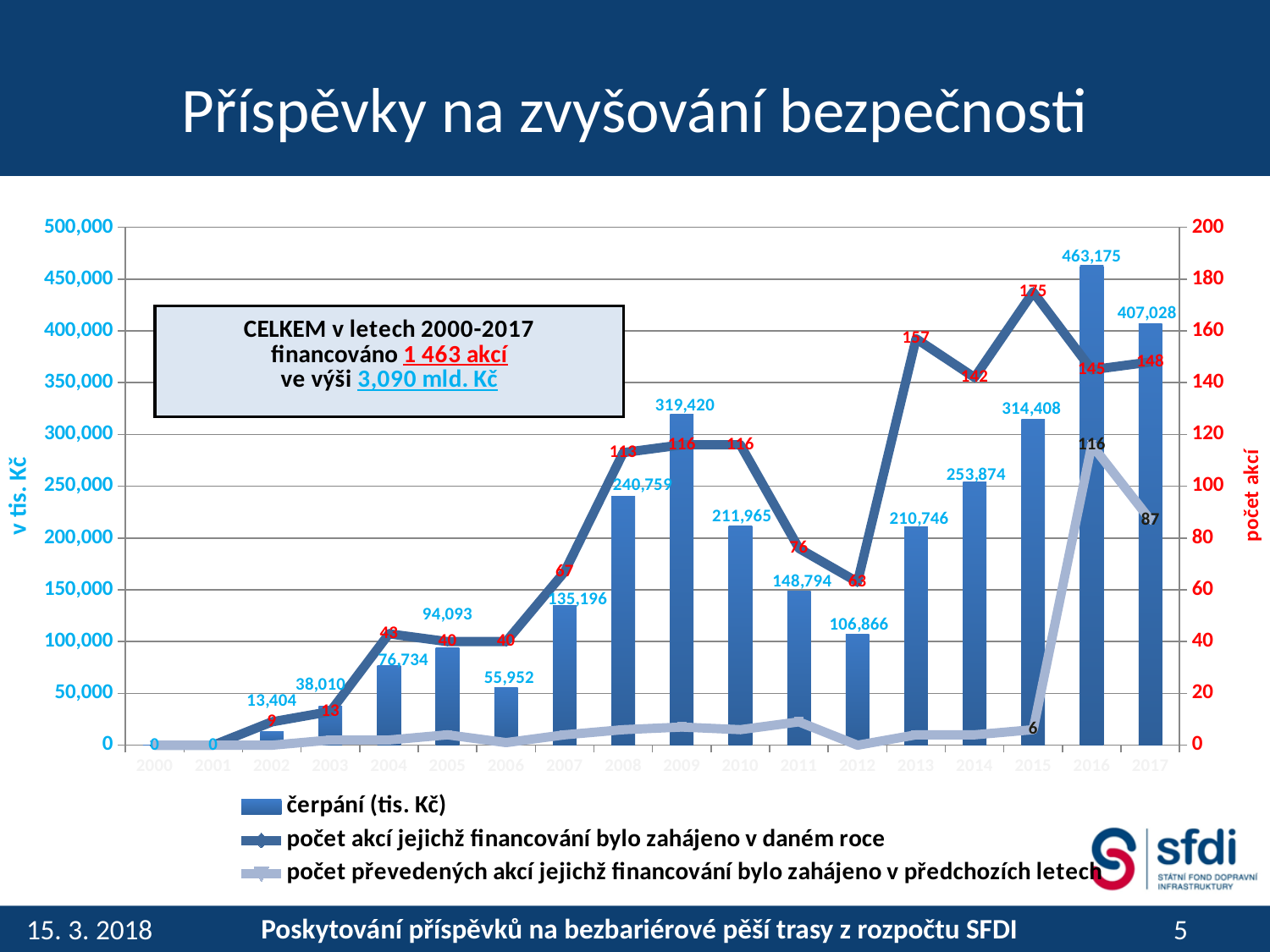
How many series does the legend list? 3 Do the čerpání bars rise or fall from 2013 to 2016? Rise What is the difference between the čerpání values for 2016 and 2017? 56,147 What kind of chart is shown on the slide? Combined bar and line chart What is the čerpání (tis. Kč) value for 2009? 319,420 What is the čerpání (tis. Kč) value for 2016? 463,175 Which year has the larger čerpání value, 2013 or 2014? 2014 According to the text box on the chart, how many akcí were financed in total in 2000-2017? 1 463 akcí How many years are shown on the x axis? 18 Which year has the highest čerpání (tis. Kč) bar? 2016 What is the value of 'počet akcí jejichž financování bylo zahájeno v daném roce' for 2015? 175 What is the value of 'počet převedených akcí jejichž financování bylo zahájeno v předchozích letech' for 2017? 87